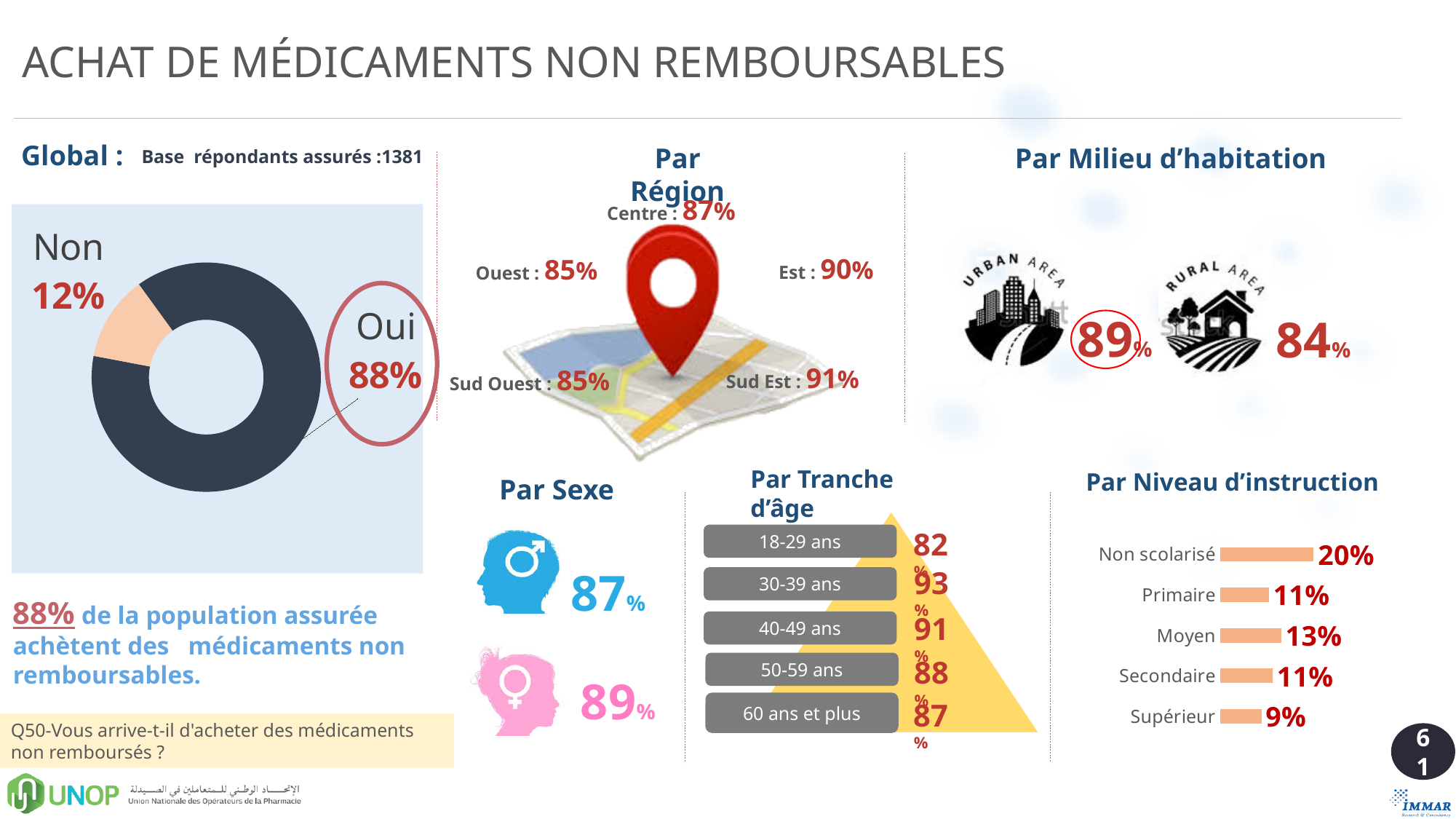
On the 'Par Niveau d'instruction' chart, which category has the lowest value? Supérieur On the 'Global' donut chart, what percentage is shown for 'Non'? 12% What type of chart is used in the 'Par Niveau d'instruction' section? Bar chart What type of chart is used in the 'Global' section? Donut chart On the 'Global' donut chart, how many slices are there? 2 On the 'Par Niveau d'instruction' chart, which category has the highest value? Non scolarisé On the 'Global' donut chart, what percentage is shown for 'Oui'? 88% On the 'Par Niveau d'instruction' chart, how many categories are shown? 5 On the 'Global' donut chart, what is the difference between the 'Oui' and 'Non' shares? 76% On the 'Par Niveau d'instruction' chart, what is the value for 'Non scolarisé'? 20% On the 'Par Niveau d'instruction' chart, what is the value for 'Moyen'? 13% On the 'Par Niveau d'instruction' chart, what is the difference between 'Non scolarisé' and 'Supérieur'? 11%